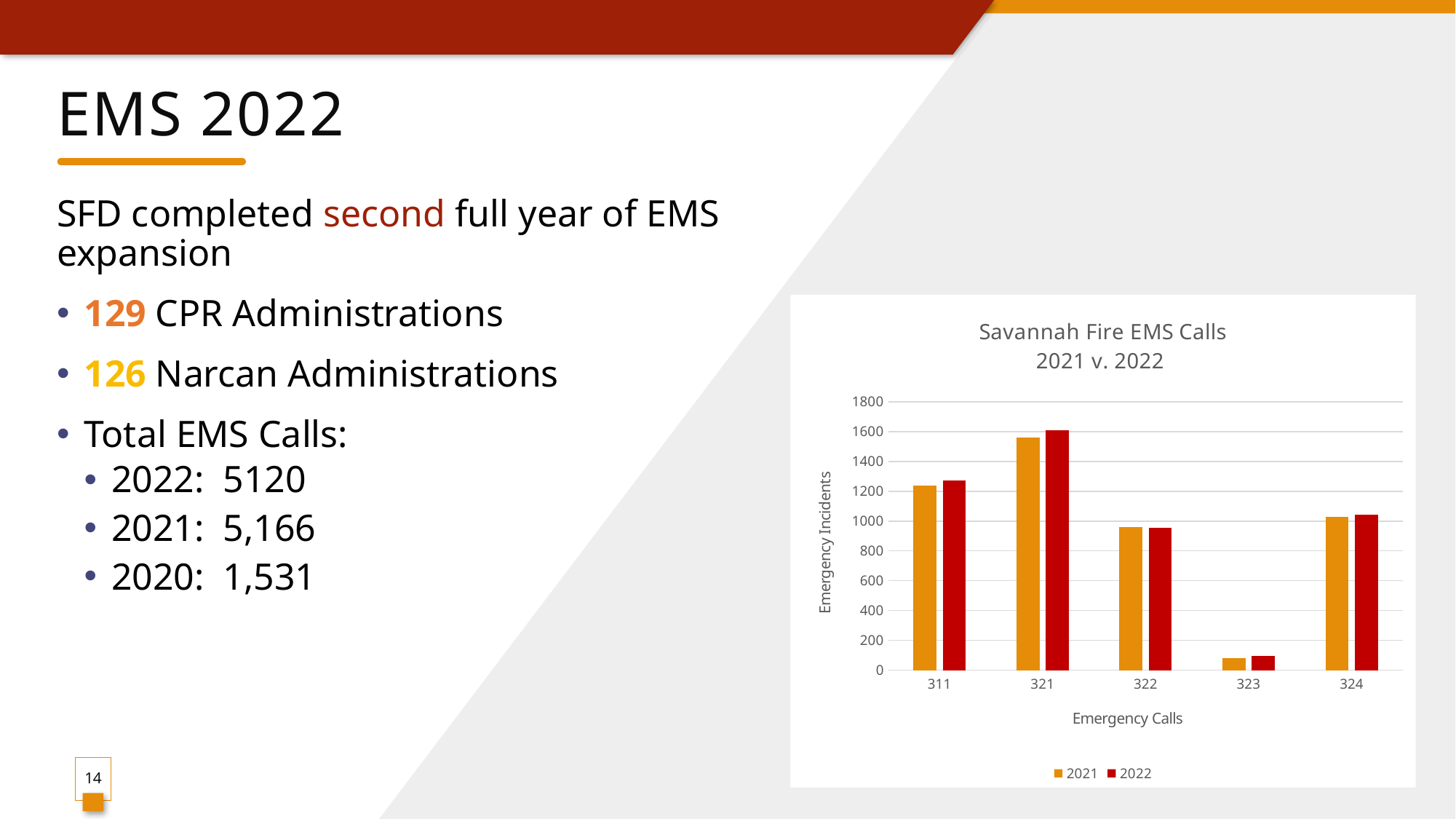
How many series does the chart legend list? 2 Which emergency call category has the lowest number of incidents for 2021? 323 How many emergency call categories are shown on the x axis? 5 Which emergency call category has the highest number of incidents for 2022? 321 For 2022, which category has the larger value, 311 or 321? 321 Is the 2021 value for category 321 greater or less than 1400? greater For category 321, which year has the larger value, 2021 or 2022? 2022 What type of chart is shown on the slide? bar chart Is the 2021 value for category 324 greater or less than 800? greater What is the title of the chart? Savannah Fire EMS Calls 2021 v. 2022 Is the 2022 value for category 323 greater or less than 200? less